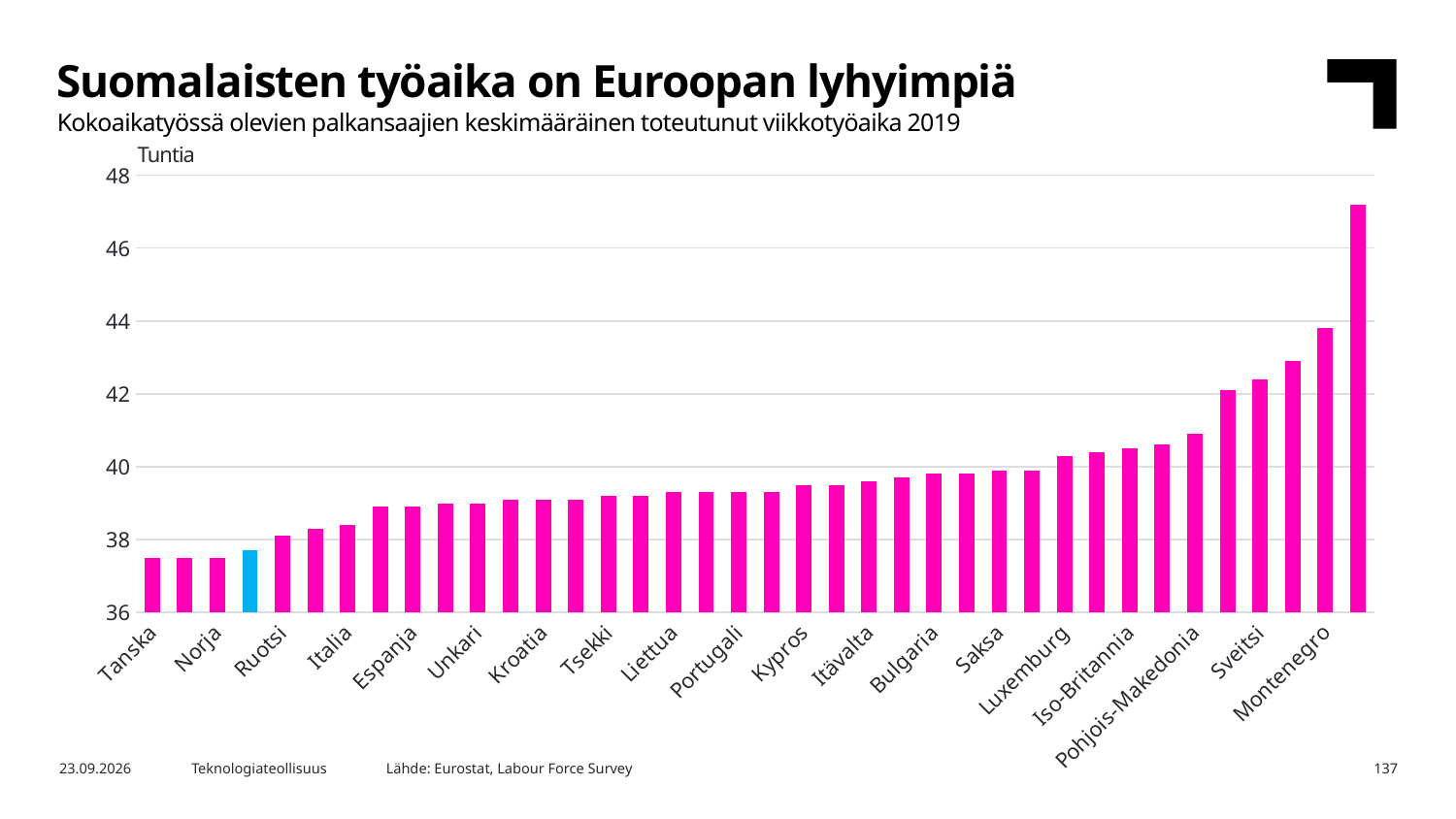
Do the bar values rise or fall from left to right along the x axis? rise Is the value for Sveitsi greater or less than 40? greater Which has a larger value, Montenegro or Tanska? Montenegro What kind of chart is shown on the slide? bar chart What unit is shown on the vertical axis of the chart? Tuntia Is the value for Pohjois-Makedonia greater or less than 40? greater What is the title of the chart on the slide? Suomalaisten työaika on Euroopan lyhyimpiä Is the value for Montenegro greater or less than 42? greater Which has a larger value, Sveitsi or Norja? Sveitsi